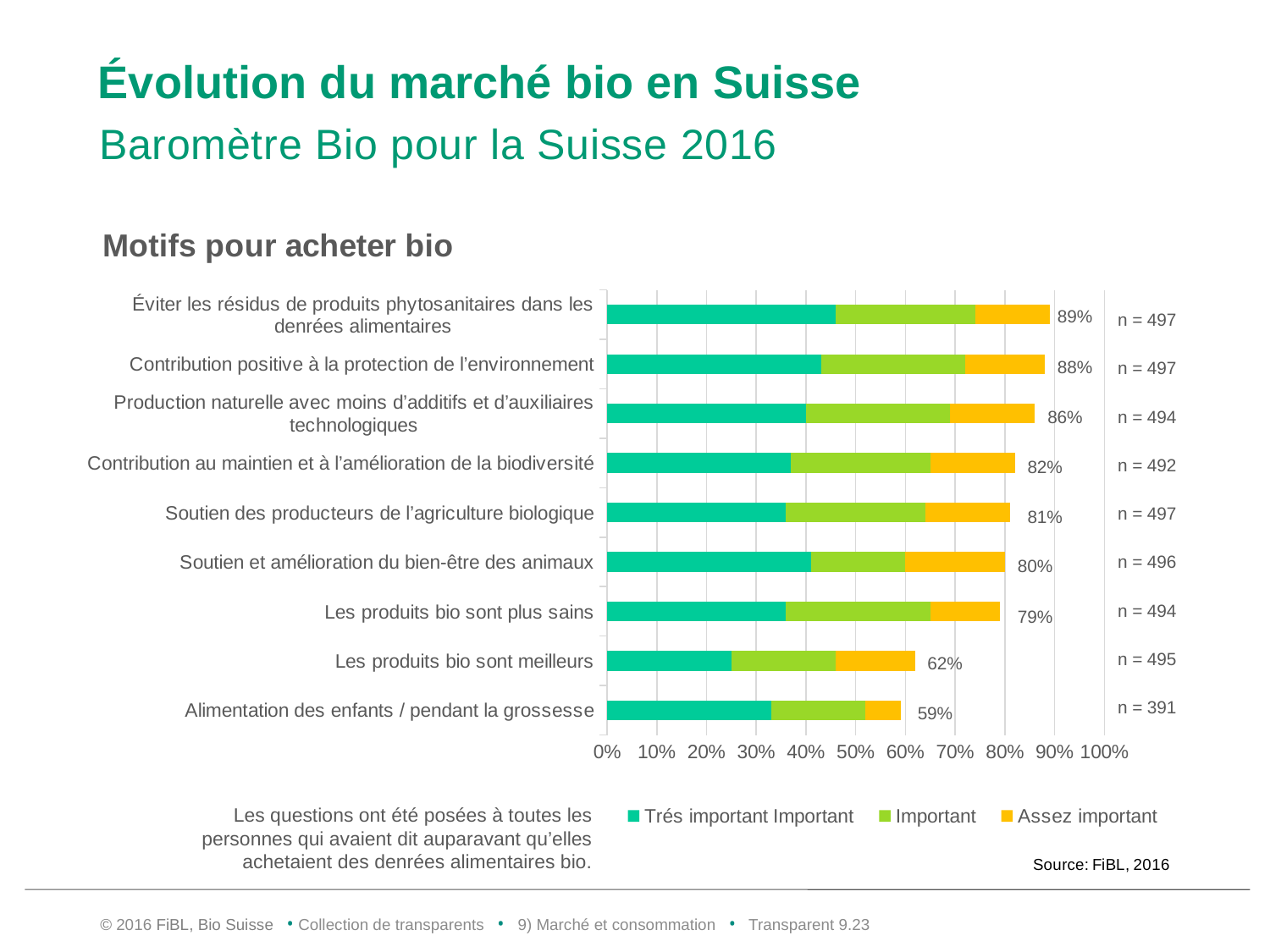
Which has a larger total: "Soutien des producteurs de l'agriculture biologique" or "Soutien et amélioration du bien-être des animaux"? Soutien des producteurs de l'agriculture biologique What is the total value shown for "Contribution au maintien et à l'amélioration de la biodiversité"? 82% What is the total value shown for "Alimentation des enfants / pendant la grossesse"? 59% How many series does the legend list? 3 How many categories (motives) are shown in the chart? 9 What kind of chart is shown on the slide? Stacked bar chart Which category has the lowest total value? Alimentation des enfants / pendant la grossesse Which category has the highest total value? Éviter les résidus de produits phytosanitaires dans les denrées alimentaires What is the difference between the total for "Les produits bio sont plus sains" and the total for "Les produits bio sont meilleurs"? 17% What is the total value shown for "Les produits bio sont meilleurs"? 62% Is the "Trés important Important" segment for "Les produits bio sont meilleurs" greater or less than 30%? less What is the sample size (n) shown for "Alimentation des enfants / pendant la grossesse"? n = 391